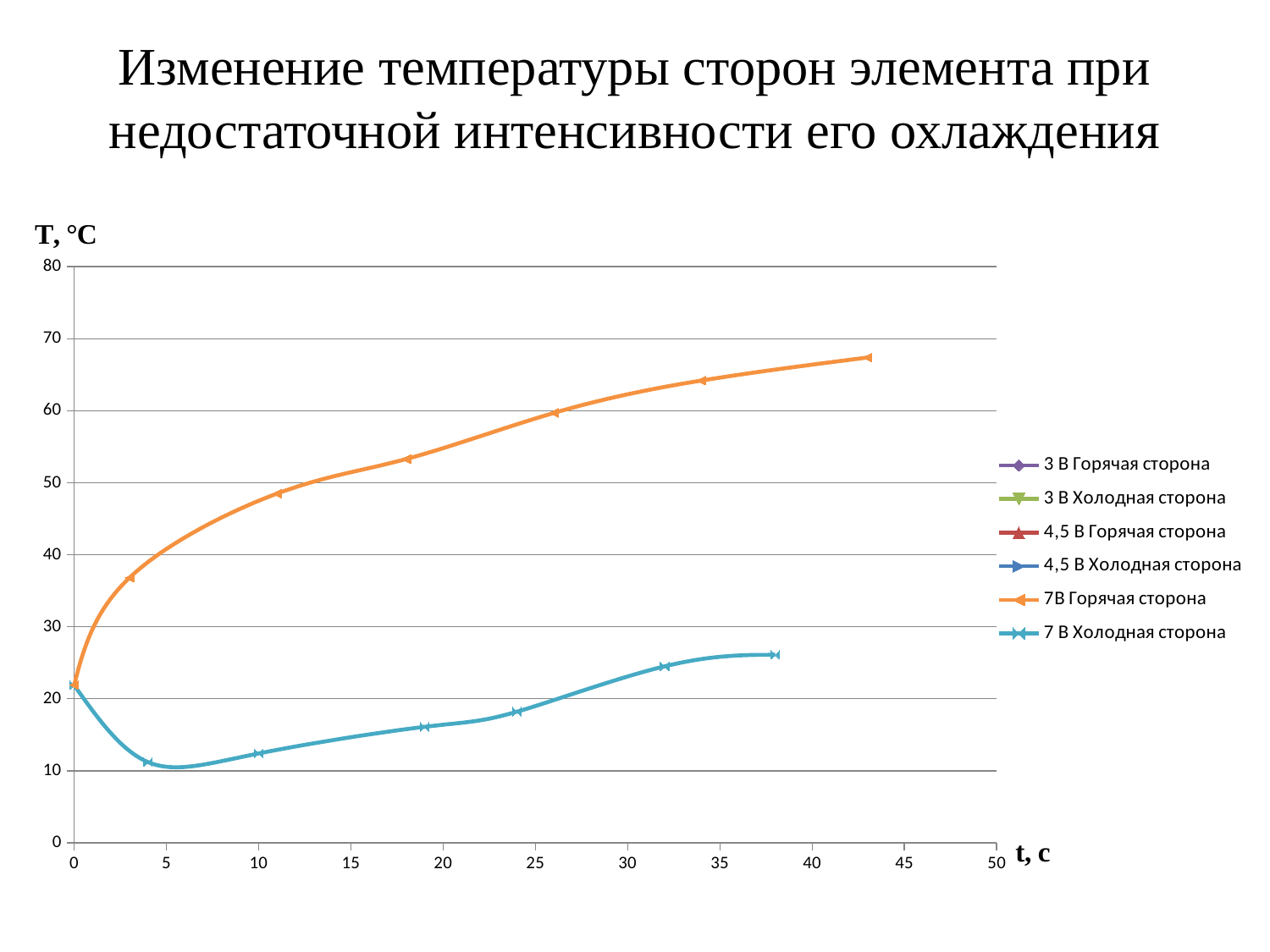
Is the value of the 7В Горячая сторона series at t = 3 greater or less than 30? greater What colour is the line for the 7В Горячая сторона series? Orange Does the 7В Горячая сторона series rise or fall as t increases? Rises What is the label of the vertical axis? T, °C How many data points are plotted for the 7В Горячая сторона series? 7 What kind of chart is shown on the slide? Line chart How many series does the legend list? 6 Is the value of the 7 В Холодная сторона series at t = 4 greater or less than 20? less At t = 19, which series has the higher temperature: 7В Горячая сторона or 7 В Холодная сторона? 7В Горячая сторона Is the value of the 7 В Холодная сторона series at t = 38 greater or less than 30? less Does the 7 В Холодная сторона series rise or fall between t = 10 and t = 38? Rises